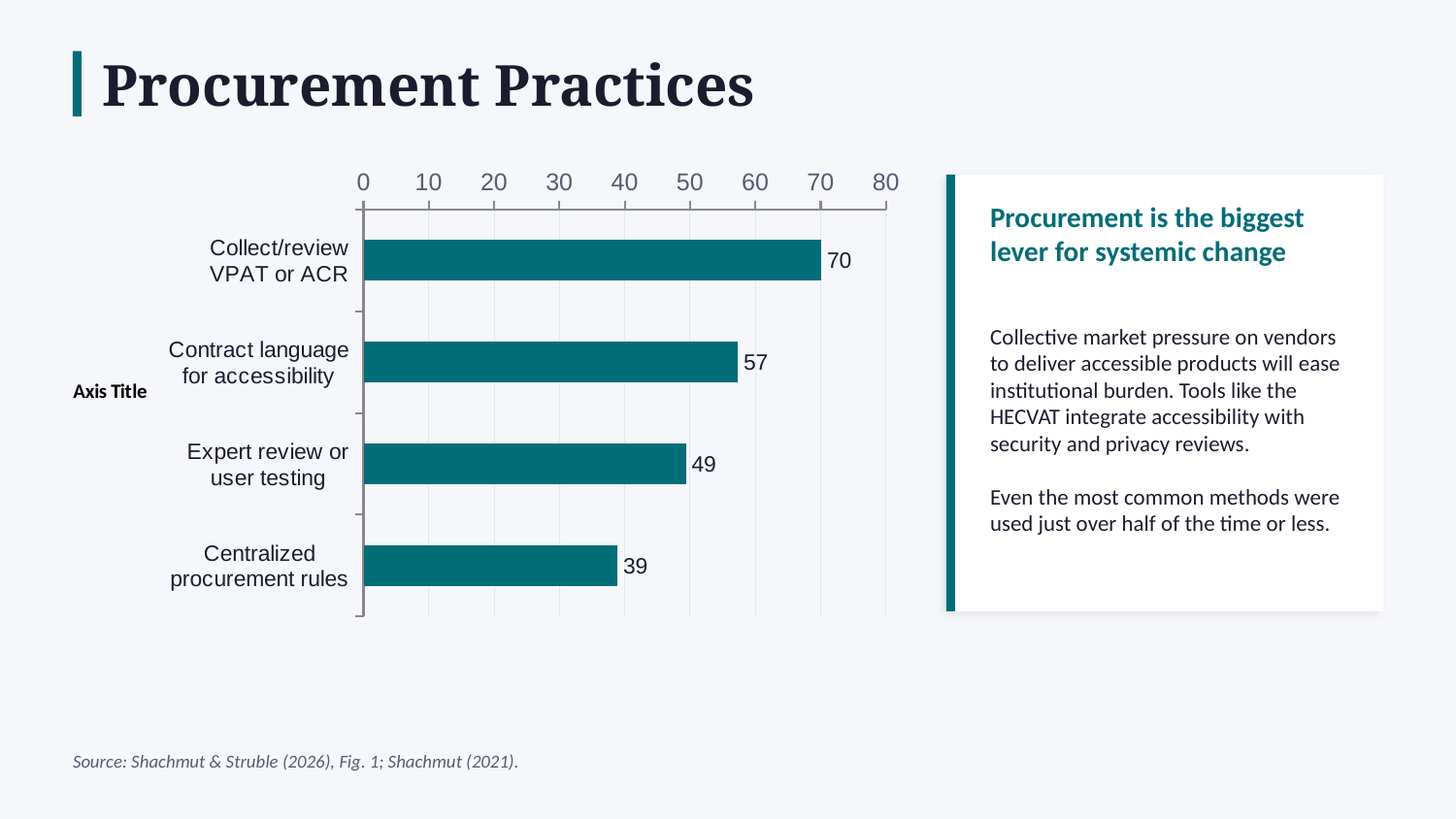
How many categories are shown in the chart? 4 Which category has the lowest value? Centralized procurement rules What is the value for Collect/review VPAT or ACR? 70 Is the value for Contract language for accessibility greater or less than 50? greater Which is larger, the value for Expert review or user testing or the value for Centralized procurement rules? Expert review or user testing What is the difference between the values for Collect/review VPAT or ACR and Centralized procurement rules? 31 What is the value for Expert review or user testing? 49 What is the difference between the values for Contract language for accessibility and Expert review or user testing? 8 Which category has the highest value? Collect/review VPAT or ACR What is the value for Centralized procurement rules? 39 What kind of chart is shown on the slide? bar chart What is the value for Contract language for accessibility? 57